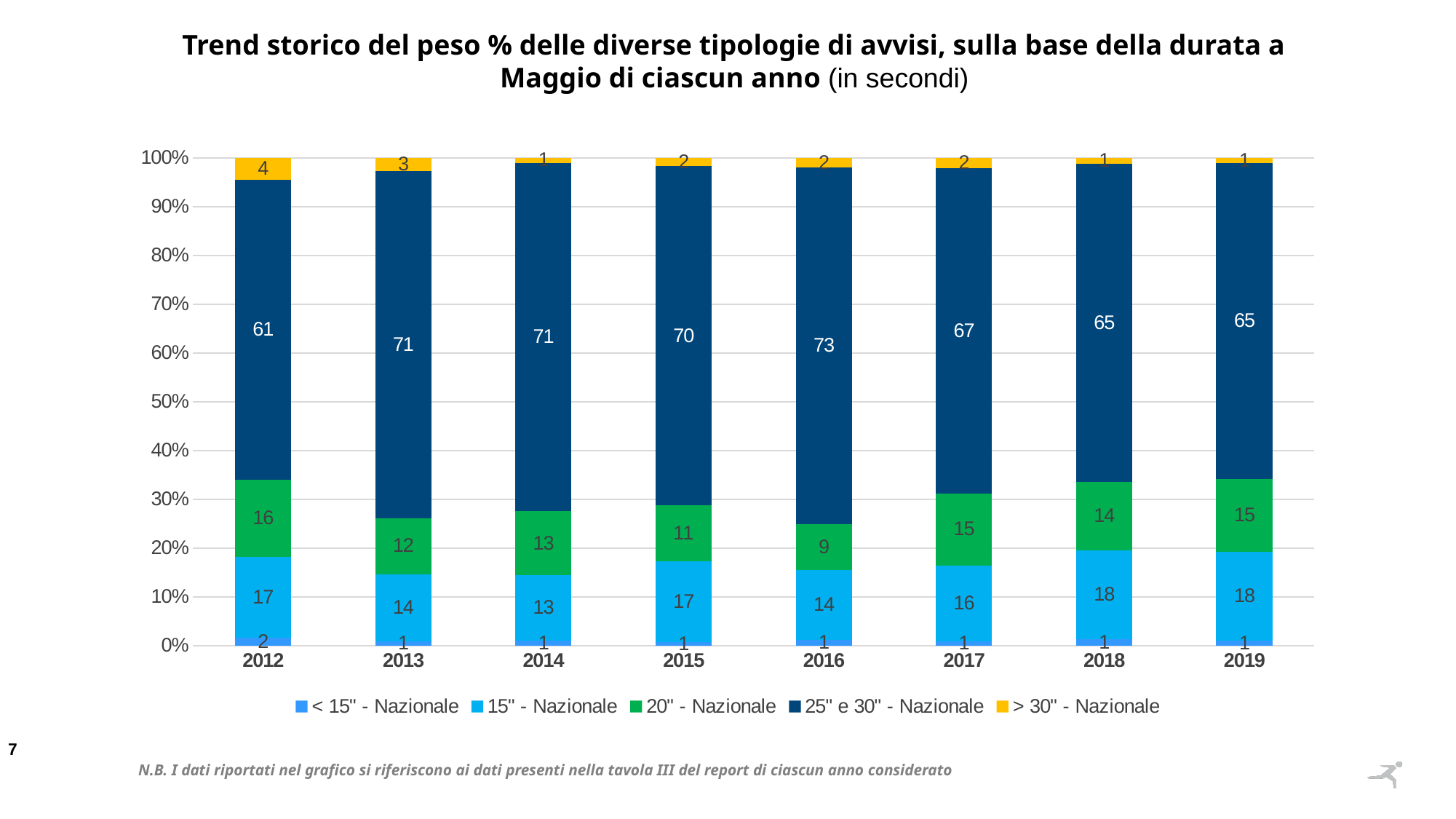
How many years are shown on the x axis? 8 In which year is the 20'' - Nazionale series lowest? 2016 What is the value for the 15'' - Nazionale series in 2019? 18 In which year is the 25'' e 30'' - Nazionale series highest? 2016 What is the value for the 25'' e 30'' - Nazionale series in 2016? 73 What kind of chart is shown on the slide? Stacked bar chart What colour represents the 20'' - Nazionale series? Green What is the difference between the 25'' e 30'' - Nazionale values for 2013 and 2012? 10 What is the value for the 20'' - Nazionale series in 2012? 16 Which year has the larger value for 15'' - Nazionale, 2015 or 2016? 2015 What is the value for the > 30'' - Nazionale series in 2012? 4 How many series does the legend list? 5